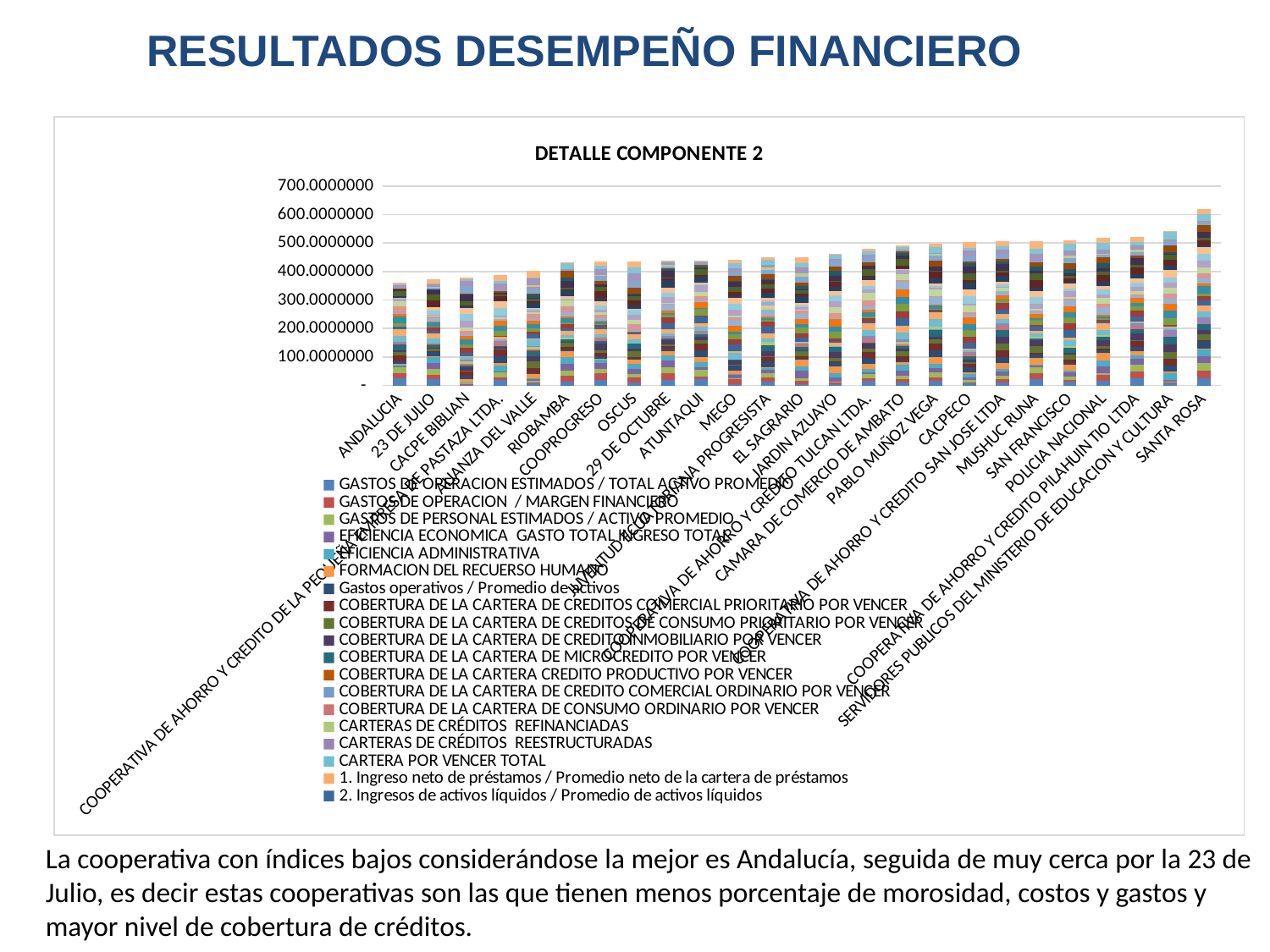
Is the total value for SANTA ROSA greater or less than 600? greater Which has the larger total bar, SANTA ROSA or SERVIDORES PUBLICOS DEL MINISTERIO DE EDUCACION Y CULTURA? SANTA ROSA Is the total value for ANDALUCIA greater or less than 400? less Do the total bar heights generally rise or fall from left to right along the x axis? Rise How many cooperatives (categories) are plotted on the x axis? 25 Is the total value for RIOBAMBA greater or less than 400? greater How many series does the legend list? 19 What kind of chart is shown on the slide? Stacked bar chart What is the title of the chart? DETALLE COMPONENTE 2 Which has the larger total bar, OSCUS or CACPECO? CACPECO Which cooperative has the highest total stacked bar? SANTA ROSA